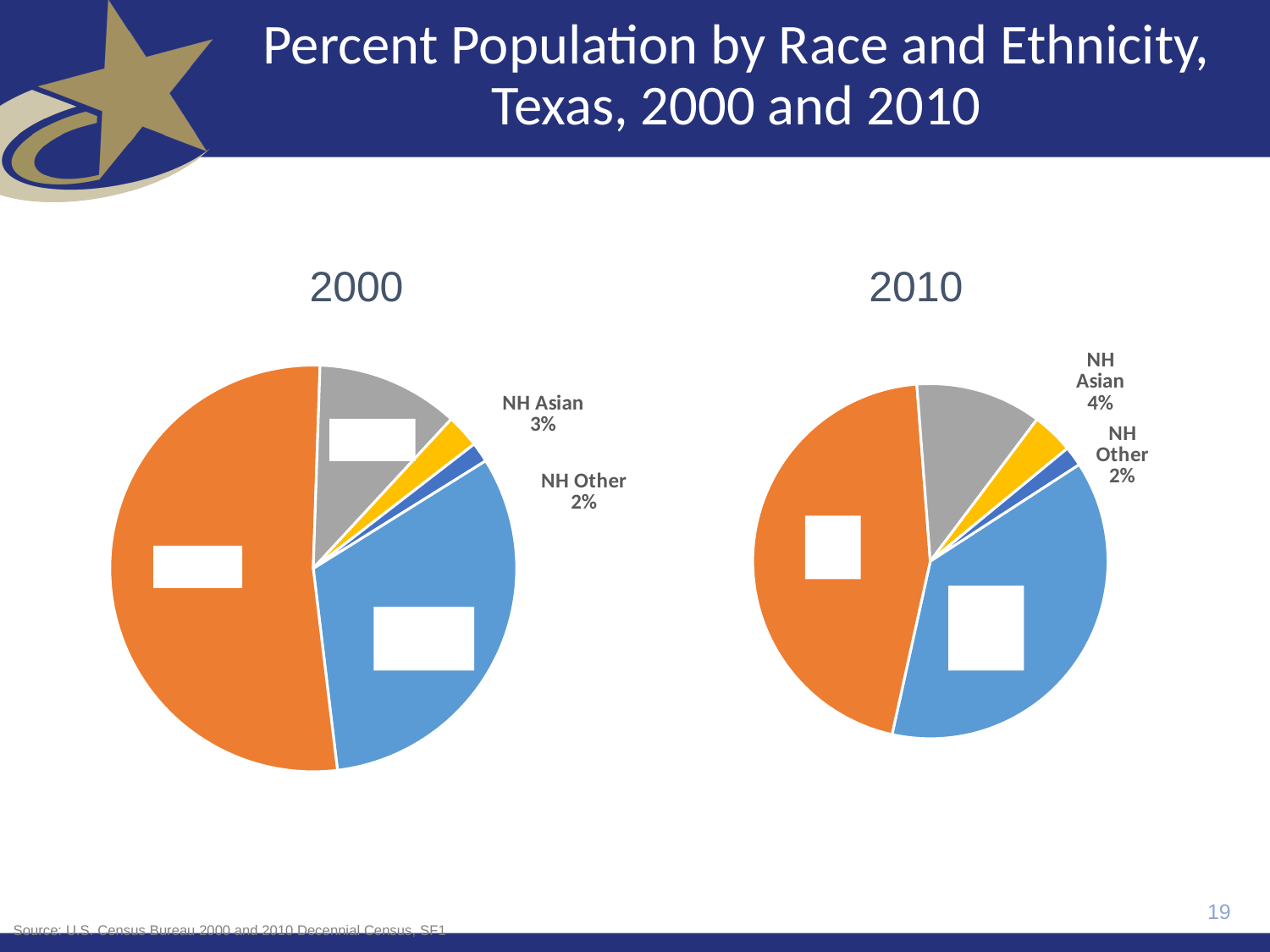
Comparing the two charts, is the NH Asian share larger in 2000 or in 2010? 2010 In the 2010 pie chart, how much larger is the NH Asian share than the NH Other share? 2% In the 2010 pie chart, what percentage is shown for NH Asian? 4% In the 2000 pie chart, what percentage is shown for NH Asian? 3% In the 2000 pie chart, what percentage is shown for NH Other? 2% In the 2010 pie chart, what colour is the largest slice? orange In the 2010 pie chart, which is larger, NH Asian or NH Other? NH Asian In the 2010 pie chart, what percentage is shown for NH Other? 2% How many slices does the 2000 pie chart have? 5 In the 2000 pie chart, what is the difference between the NH Asian share and the NH Other share? 1% What kind of chart is the 2000 chart on the slide? pie chart How many slices does the 2010 pie chart have? 5